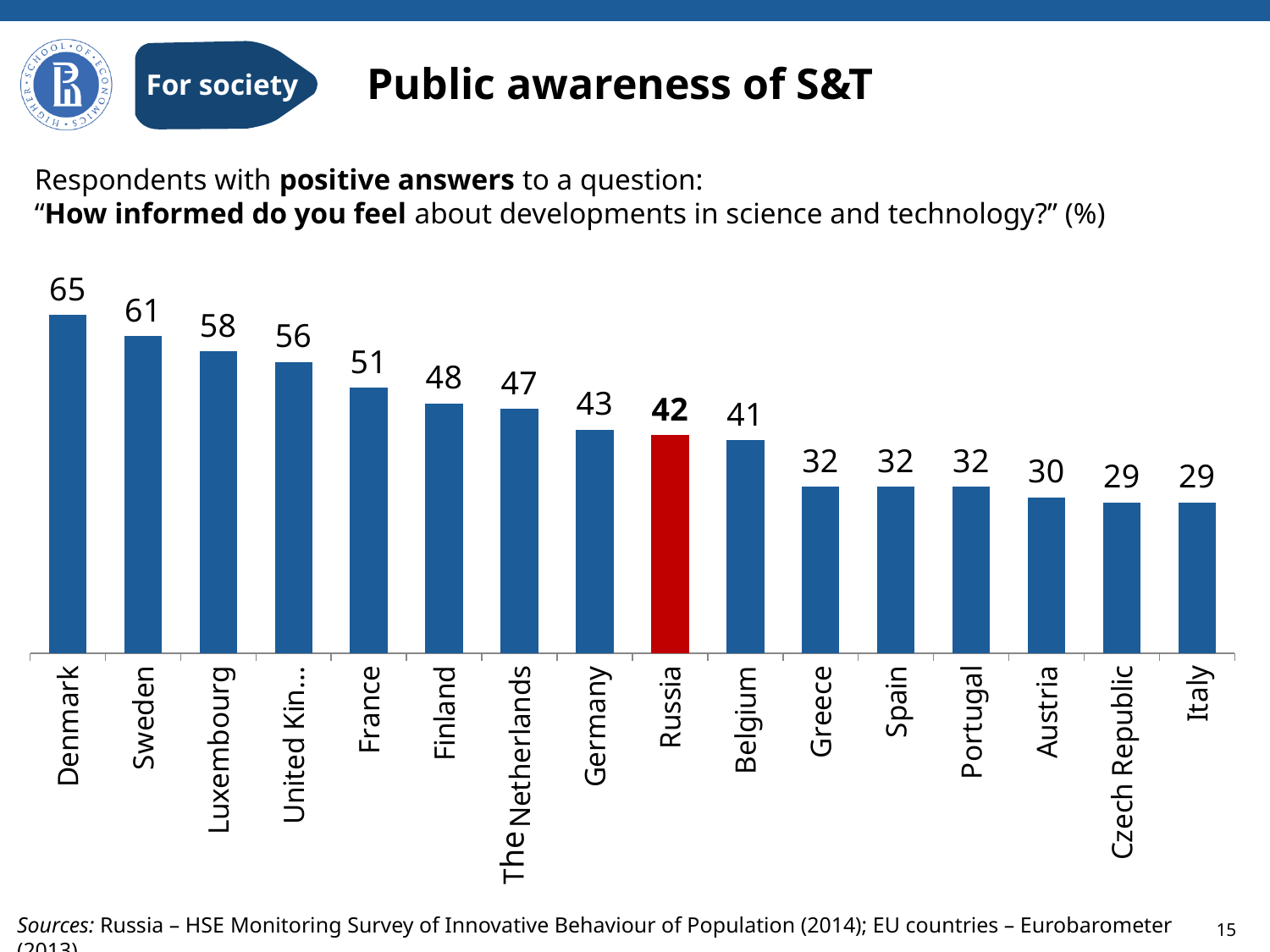
What is the value for Austria? 30 Which country's bar is highlighted in red? Russia How many countries are shown in the chart? 16 What is the value for Germany? 43 What kind of chart is shown on the slide? Bar chart Which is larger, the value for France or the value for Finland? France What is the difference between the values for Denmark and Russia? 23 What is the value for Russia? 42 Which country has the highest value? Denmark What is the value for Denmark? 65 Which is larger, the value for Belgium or the value for Greece? Belgium What is the difference between the values for Sweden and Italy? 32